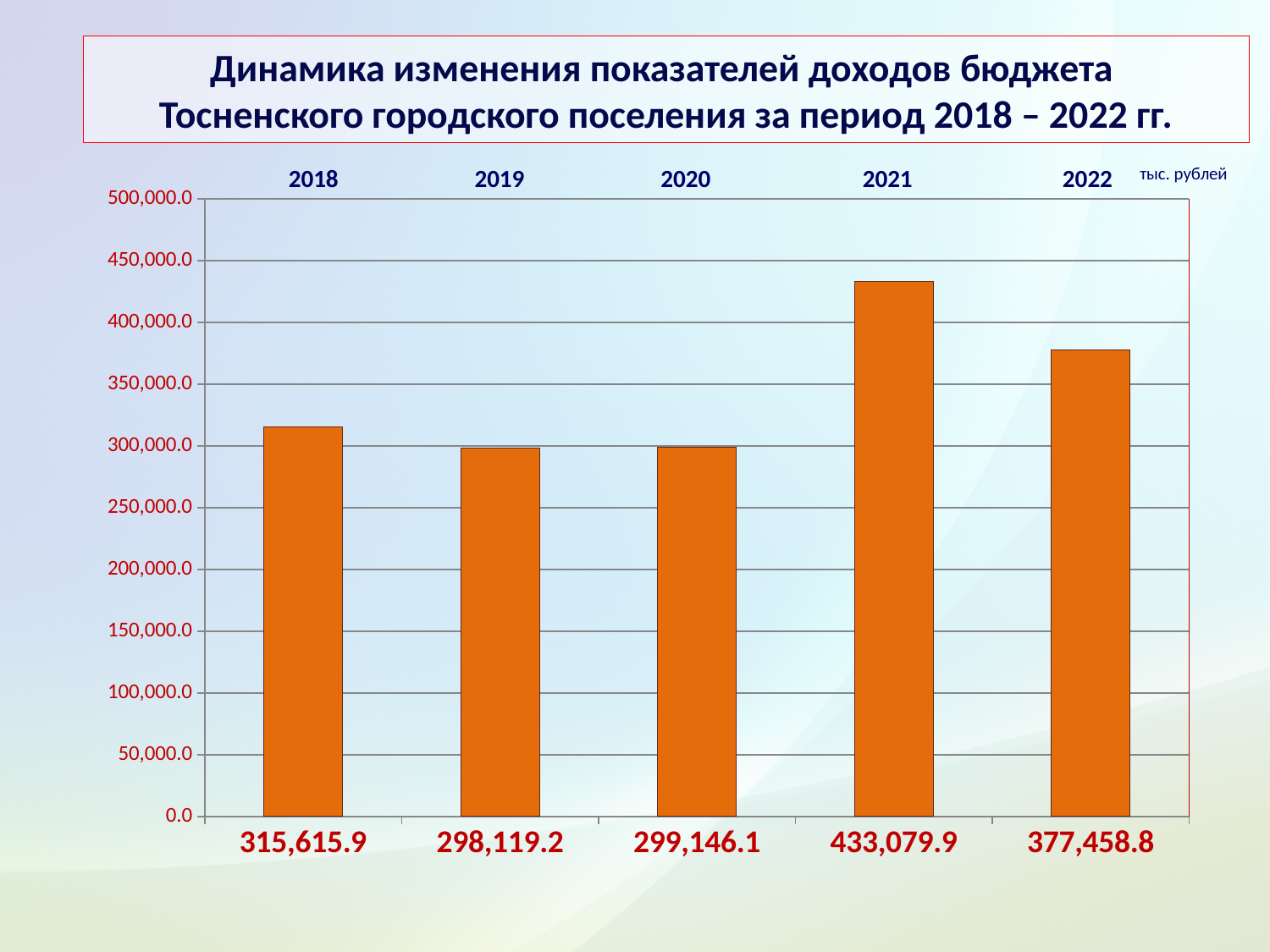
Is the value for 2021 greater or less than 400,000.0? greater Which year has the highest budget revenue? 2021 How many years (bars) are shown in the chart? 5 What is the budget revenue value shown for 2022? 377,458.8 In what units are the values on the chart expressed? тыс. рублей What type of chart is shown on the slide? bar chart What is the difference between the 2018 and 2019 values? 17,496.7 Which is larger, the value for 2018 or the value for 2022? 2022 What is the budget revenue value shown for 2018? 315,615.9 What is the difference between the 2021 and 2022 values? 55,621.1 Which year has the lowest budget revenue according to the data labels? 2019 What is the budget revenue value shown for 2021? 433,079.9